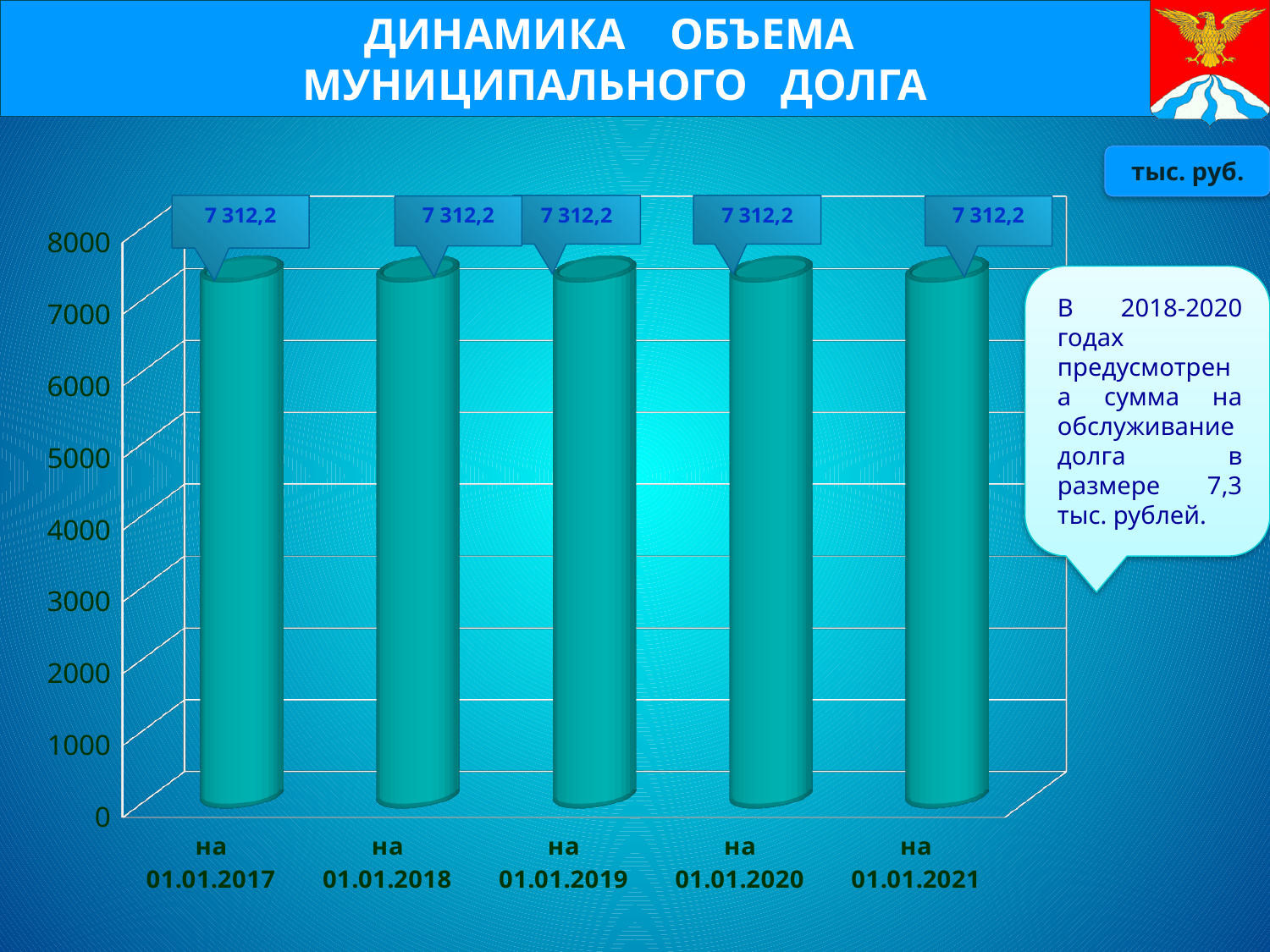
What is the value for на 01.01.2020? 7 312,2 What is the title of the chart? ДИНАМИКА ОБЪЕМА МУНИЦИПАЛЬНОГО ДОЛГА What is the value for на 01.01.2019? 7 312,2 What is the value for на 01.01.2017? 7 312,2 How many bars (dates) are shown on the chart? 5 In what units are the chart values given? тыс. руб. What kind of chart is shown on the slide? Bar chart What is the value for на 01.01.2021? 7 312,2 Do the values rise, fall or stay the same from на 01.01.2017 to на 01.01.2021? Stay the same Is the value for на 01.01.2021 greater or less than 8000? less What is the difference between the values for на 01.01.2018 and на 01.01.2020? 0 Is the value for на 01.01.2018 greater or less than 7000? greater